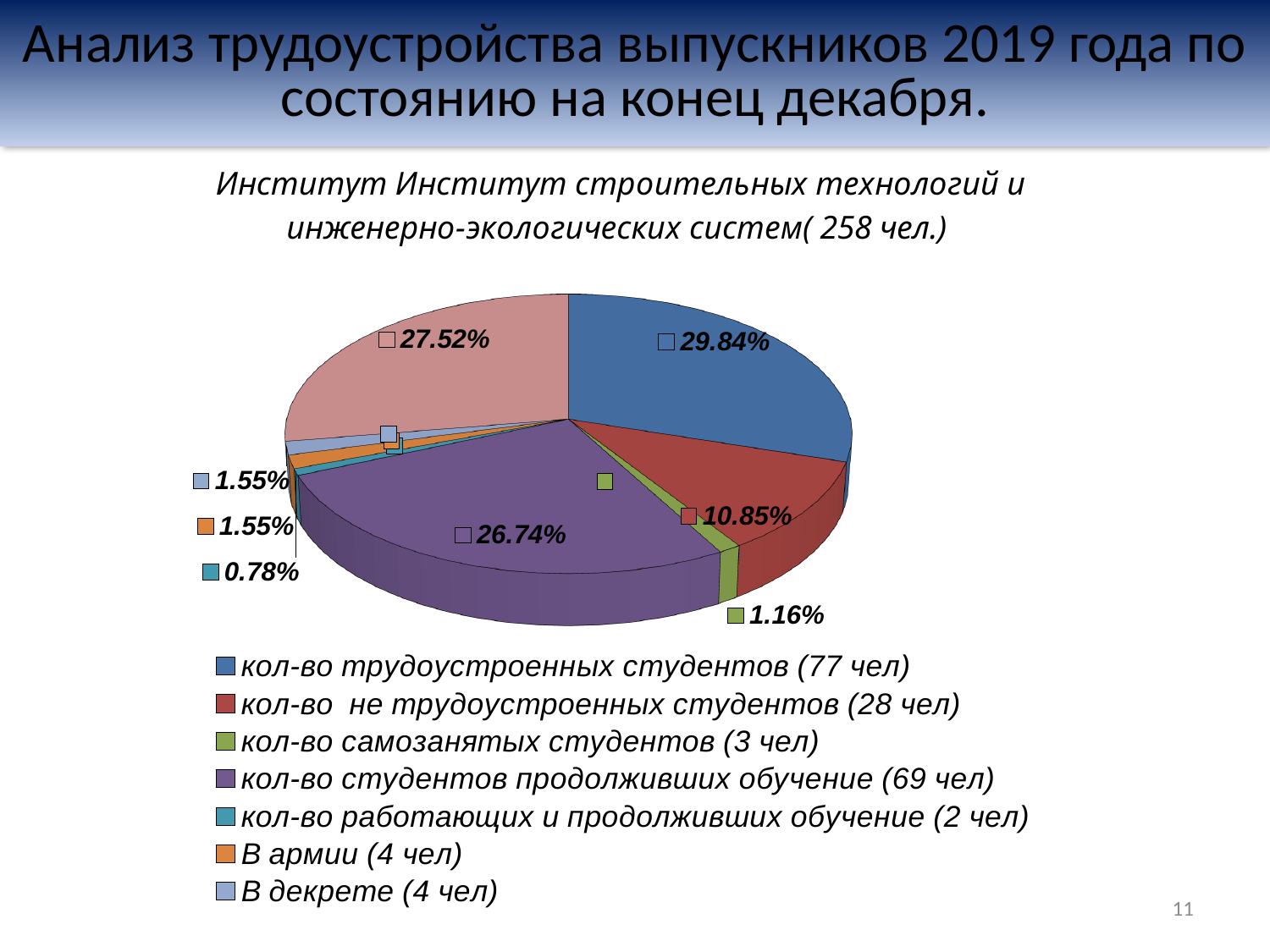
What is the difference in percentage points between the slice for employed students (29.84%) and the slice for students who continued studying (26.74%)? 3.10% What percentage is shown for 'кол-во студентов продолживших обучение (69 чел)'? 26.74% How many entries does the legend list? 7 What percentage is shown for 'кол-во работающих и продолживших обучение (2 чел)'? 0.78% Which legend category has the smallest share of the pie? кол-во работающих и продолживших обучение (2 чел) Which legend category has the largest share of the pie? кол-во трудоустроенных студентов (77 чел) What percentage is shown for 'В армии (4 чел)'? 1.55% What percentage of the pie does the slice for 'кол-во трудоустроенных студентов (77 чел)' represent? 29.84% What percentage is shown for 'кол-во не трудоустроенных студентов (28 чел)'? 10.85% What kind of chart is shown on the slide? Pie chart What percentage is shown for 'кол-во самозанятых студентов (3 чел)'? 1.16% Which is larger: the share for 'кол-во не трудоустроенных студентов' or the share for 'кол-во самозанятых студентов'? кол-во не трудоустроенных студентов